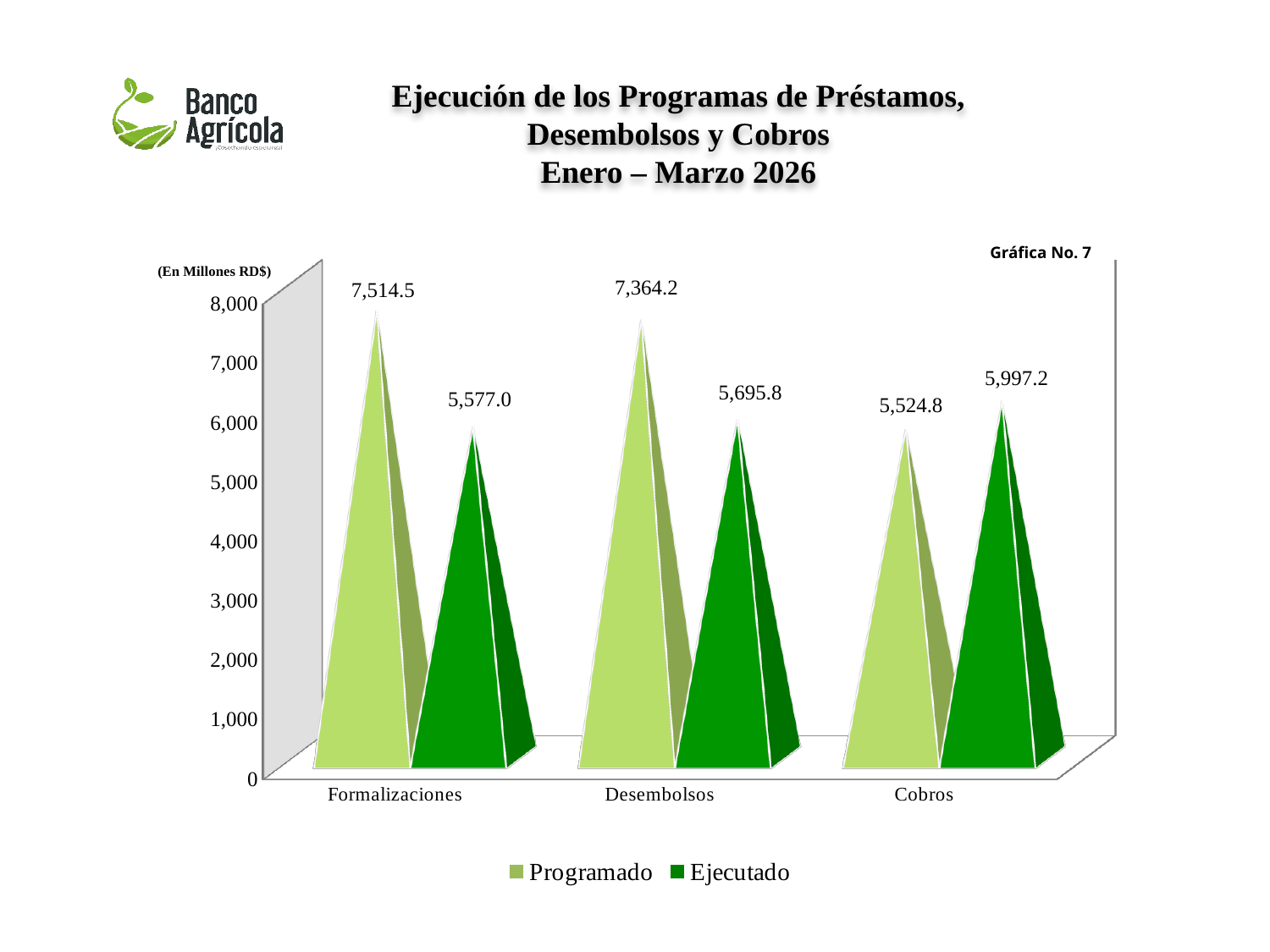
What is the Programado value for Cobros? 5,524.8 Which is larger for Desembolsos, Programado or Ejecutado? Programado Which category has the highest Programado value? Formalizaciones What unit is stated for the values in the chart? En Millones RD$ How many series does the legend list? 2 Which category has the lowest Ejecutado value? Formalizaciones What is the Ejecutado value for Desembolsos? 5,695.8 What is the difference between the Ejecutado and Programado values for Cobros? 472.4 What is the difference between the Programado and Ejecutado values for Formalizaciones? 1,937.5 What is the Ejecutado value for Cobros? 5,997.2 How many categories are shown on the x axis? 3 What is the Programado value for Formalizaciones? 7,514.5